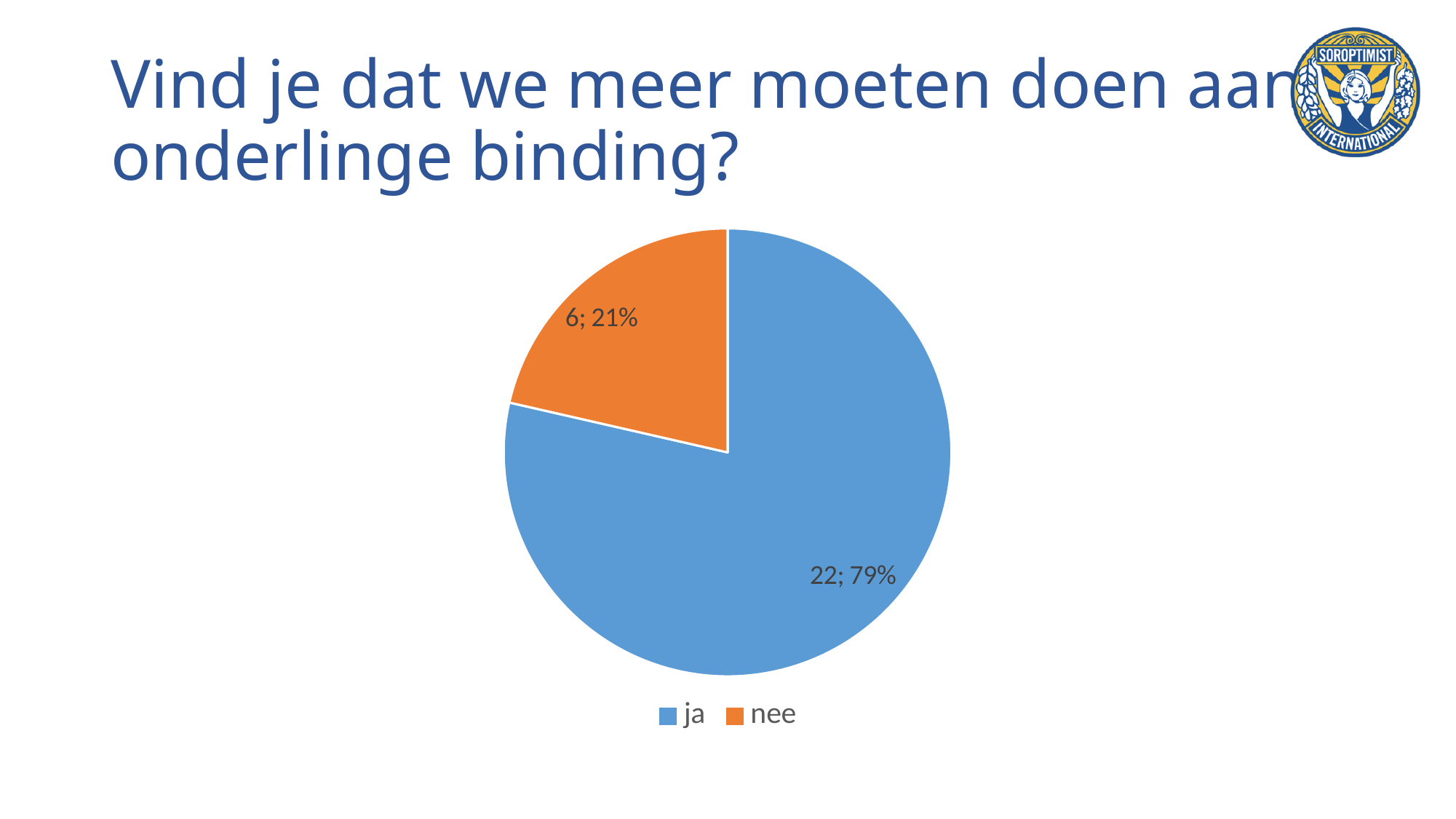
What share of the pie does "nee" represent? 21% How many entries does the legend list? 2 What is the count for "nee"? 6 Which is larger, the count for "ja" or the count for "nee"? ja What is the count for "ja"? 22 What kind of chart is shown on the slide? pie chart How many slices does the pie chart have? 2 What colour is the "nee" slice? orange What is the difference between the counts for "ja" and "nee"? 16 Which category has the largest slice? ja Which category has the smallest slice? nee What share of the pie does "ja" represent? 79%